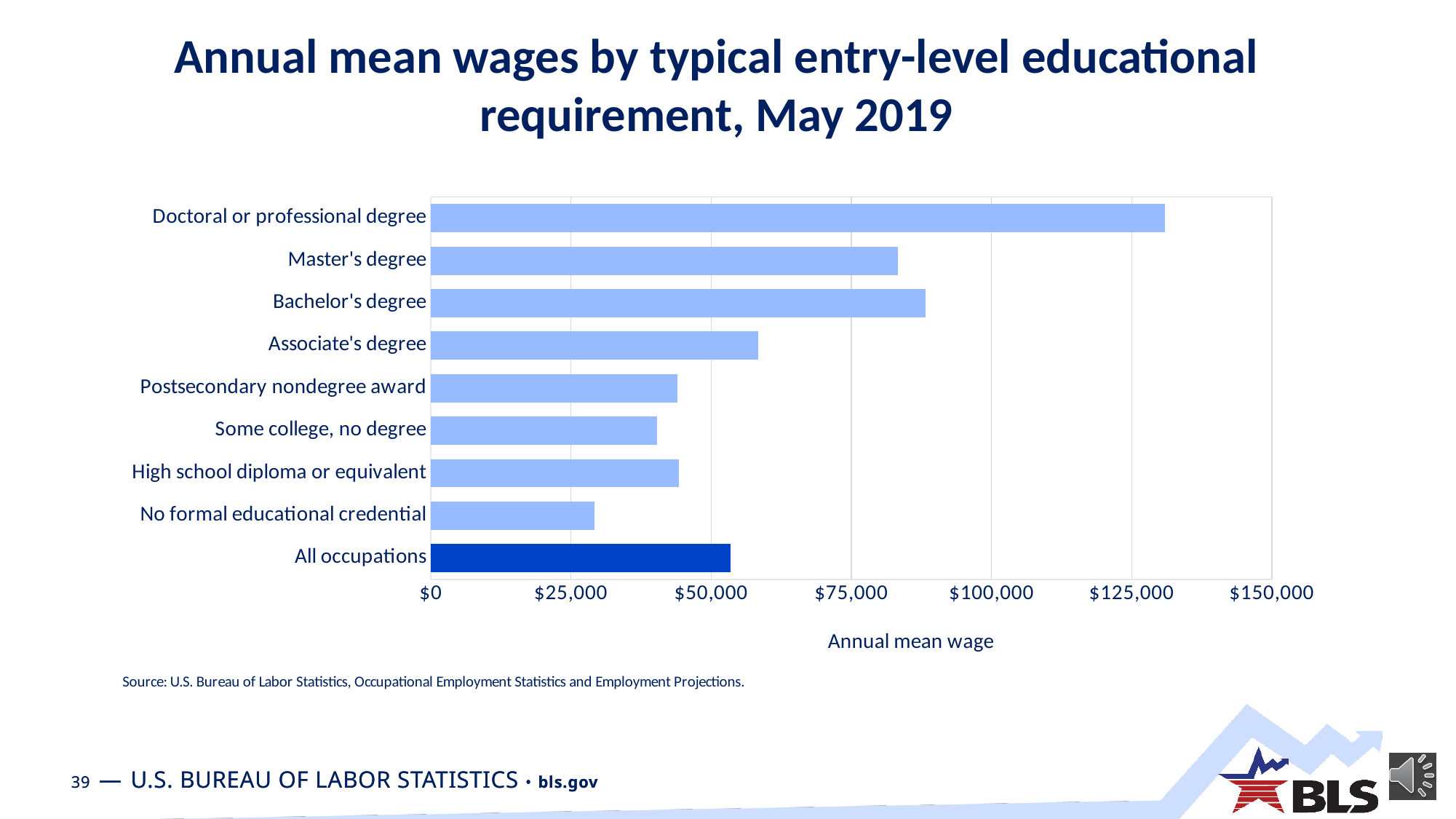
Is the value for Some college, no degree greater or less than $50,000? less Which category has the highest annual mean wage? Doctoral or professional degree Which has the higher annual mean wage, Bachelor's degree or Master's degree? Bachelor's degree Is the value for Master's degree greater or less than $75,000? greater How many categories are plotted on the chart? 9 What kind of chart is shown on the slide? bar chart What is the title of the horizontal axis? Annual mean wage Is the value for No formal educational credential greater or less than $50,000? less Which has the higher annual mean wage, Associate's degree or All occupations? Associate's degree Which bar is drawn in a darker blue than the others? All occupations Which category has the lowest annual mean wage? No formal educational credential